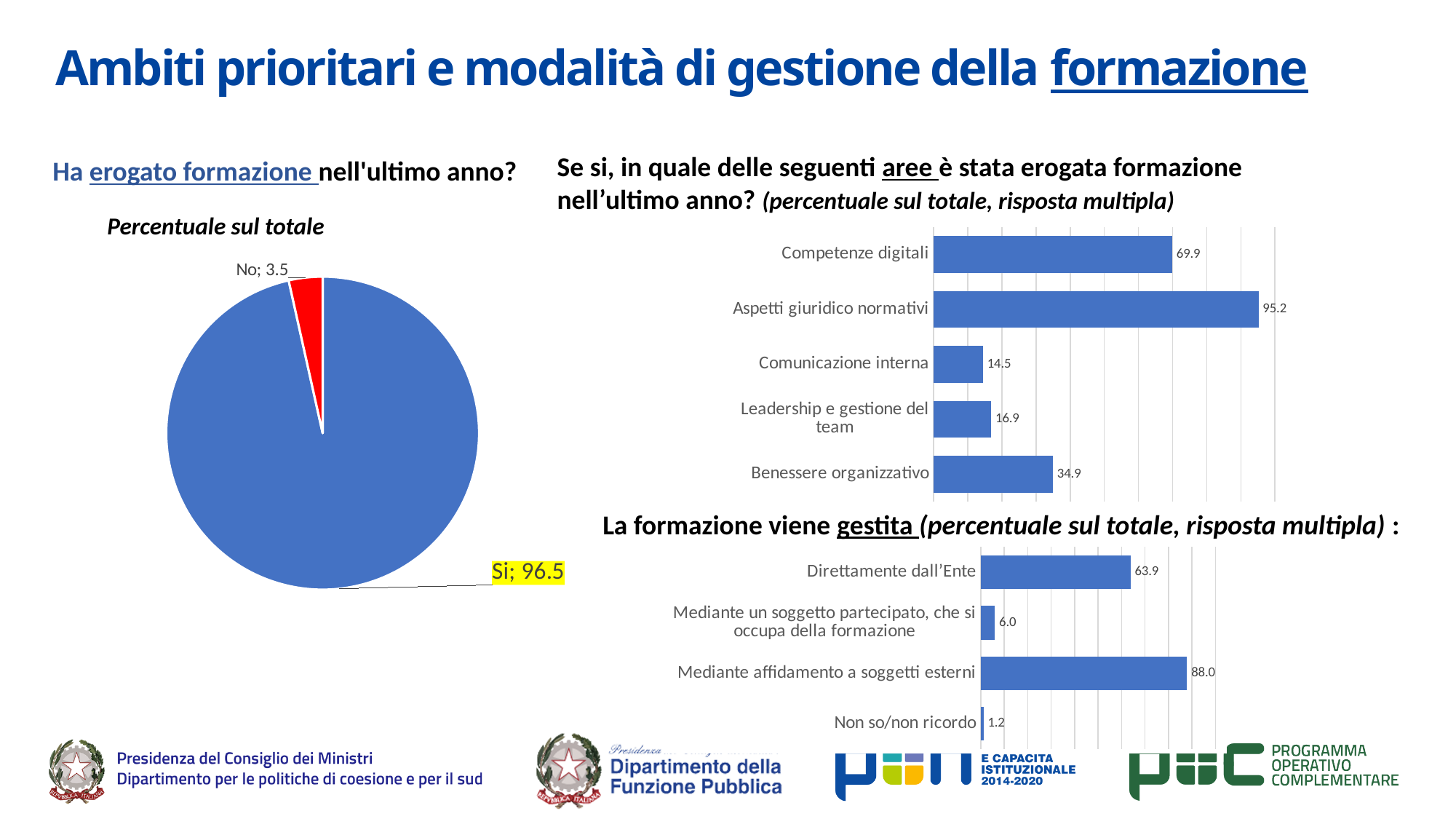
In the top-right bar chart about areas of training, which category has the highest value? Aspetti giuridico normativi In the top-right bar chart about areas of training, which category has the lowest value? Comunicazione interna In the top-right bar chart about areas of training, what is the difference between "Competenze digitali" and "Benessere organizzativo"? 35.0 What kind of chart is the bottom-right chart about how training is managed? bar chart In the pie chart on the left, what is the value for "Si"? 96.5 In the bottom-right bar chart about how training is managed, which category has the lowest value? Non so/non ricordo How many categories are shown in the top-right bar chart about areas of training? 5 In the bottom-right bar chart about how training is managed, what is the value for "Mediante affidamento a soggetti esterni"? 88.0 In the bottom-right bar chart about how training is managed, which is larger: "Direttamente dall'Ente" or "Mediante un soggetto partecipato, che si occupa della formazione"? Direttamente dall'Ente What kind of chart is the chart on the left of the slide? pie chart In the pie chart on the left, what is the value for "No"? 3.5 In the top-right bar chart about areas of training, what is the value for "Aspetti giuridico normativi"? 95.2